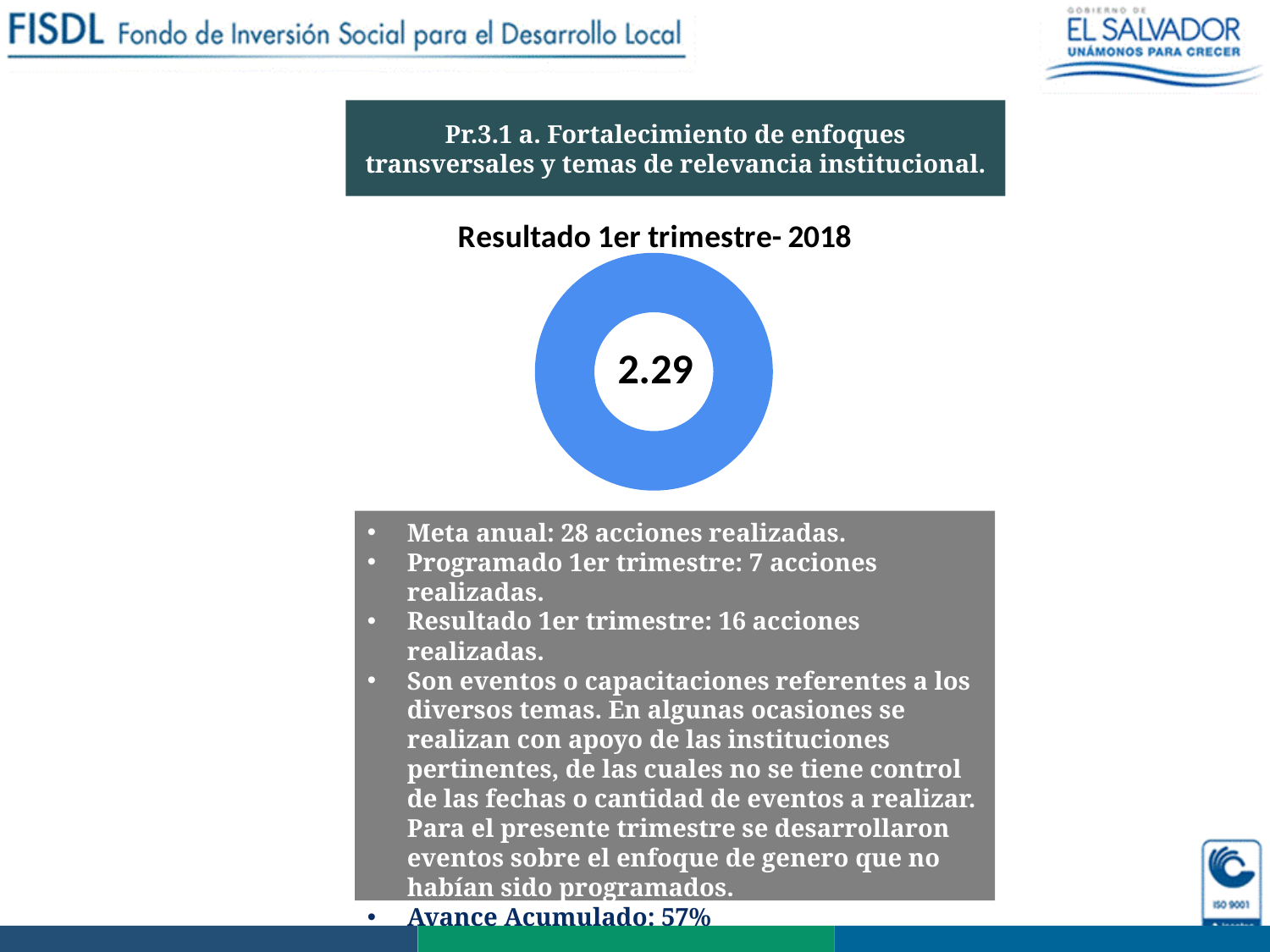
What colour is the ring of the doughnut chart? Blue What is the title shown above the doughnut chart? Resultado 1er trimestre- 2018 What value is printed in the centre of the doughnut chart? 2.29 What kind of chart is shown under the heading "Resultado 1er trimestre- 2018"? Doughnut chart How many distinct segments does the doughnut chart ring show? 1